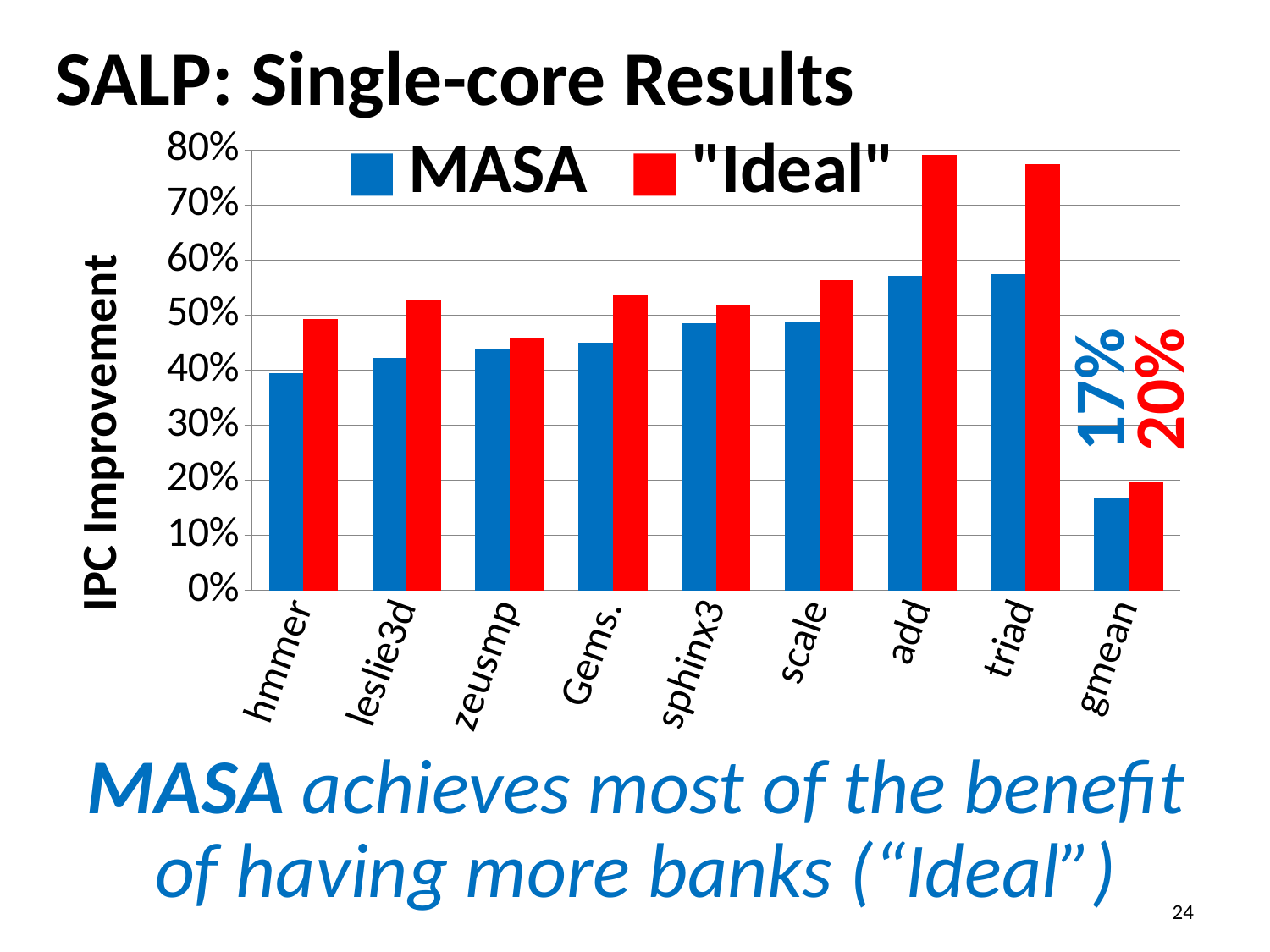
What kind of chart is shown on the slide? bar chart Is the "Ideal" value for hmmer greater or less than 40%? greater What is the MASA IPC improvement for gmean? 17% What is the label on the y axis? IPC Improvement What is the difference between the "Ideal" and MASA values for gmean? 3% How many categories are shown along the x axis? 9 For add, which series has the larger value, MASA or "Ideal"? "Ideal" How many series does the legend list? 2 Is the "Ideal" value for zeusmp greater or less than 50%? less Which category has the lowest MASA value? gmean Is the "Ideal" value for add greater or less than 70%? greater What is the "Ideal" IPC improvement for gmean? 20%